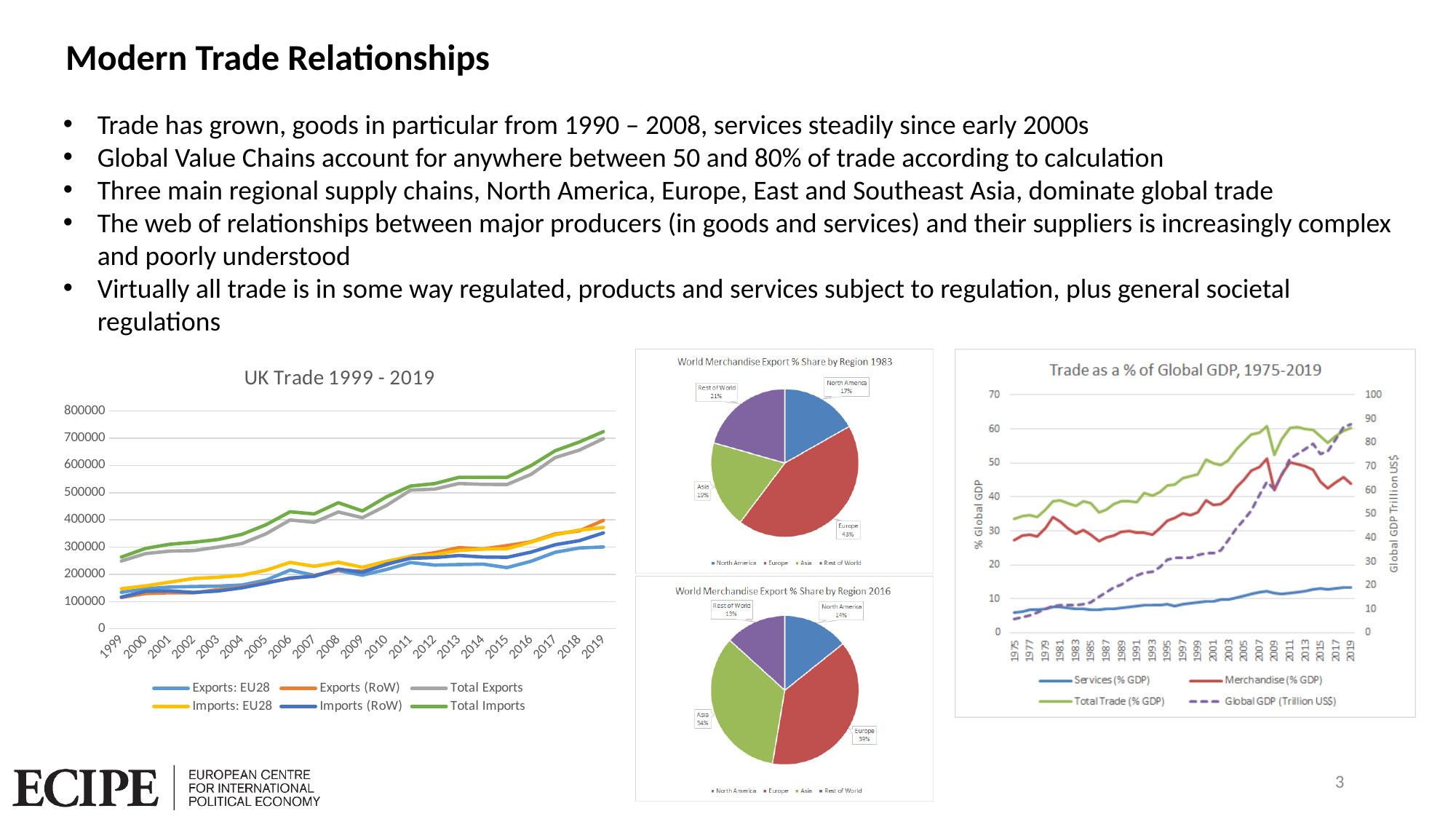
In the 'World Merchandise Export % Share by Region 2016' pie chart, which is larger, the share of Asia or the share of North America? Asia In the 'World Merchandise Export % Share by Region 2016' pie chart, how many regions are shown? 4 In the 'UK Trade 1999 - 2019' chart, is the value for Total Imports in 2019 greater or less than 600000? greater In the 'World Merchandise Export % Share by Region 2016' pie chart, what share does Asia have? 34% In the 'Trade as a % of Global GDP, 1975-2019' chart, does the Total Trade (% GDP) series generally rise or fall from 1975 to 2019? rise In the 'World Merchandise Export % Share by Region 2016' pie chart, which region has the smallest share? Rest of World In the 'World Merchandise Export % Share by Region 1983' pie chart, which region has the largest share? Europe What kind of chart is 'Trade as a % of Global GDP, 1975-2019'? Line chart In the 'World Merchandise Export % Share by Region 1983' pie chart, what share does Europe have? 43% How many series does the legend of the 'UK Trade 1999 - 2019' chart list? 6 How many series does the legend of the 'Trade as a % of Global GDP, 1975-2019' chart list? 4 In the 'World Merchandise Export % Share by Region 1983' pie chart, what is the difference between the shares of Europe and North America? 26%